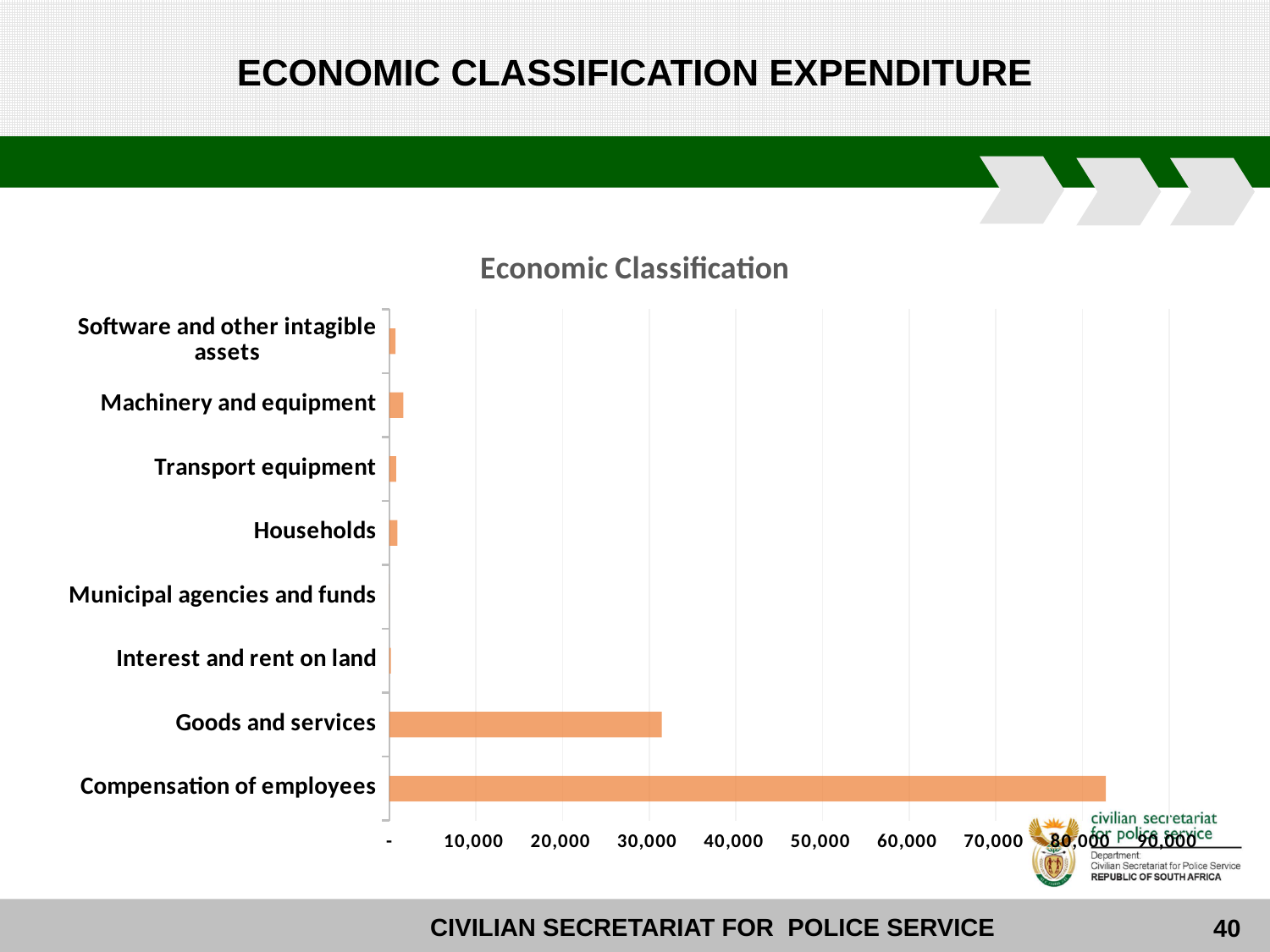
Which is larger, the value for Compensation of employees or the value for Goods and services? Compensation of employees Is the value for Machinery and equipment greater or less than 10,000? less What colour are the bars in the chart? Orange Is the value for Goods and services greater or less than 40,000? less What kind of chart is shown on the slide? Bar chart Which is larger, the value for Goods and services or the value for Machinery and equipment? Goods and services Is the value for Goods and services greater or less than 20,000? greater How many categories are shown on the chart? 8 Which category has the highest value? Compensation of employees What is the title of the chart? Economic Classification